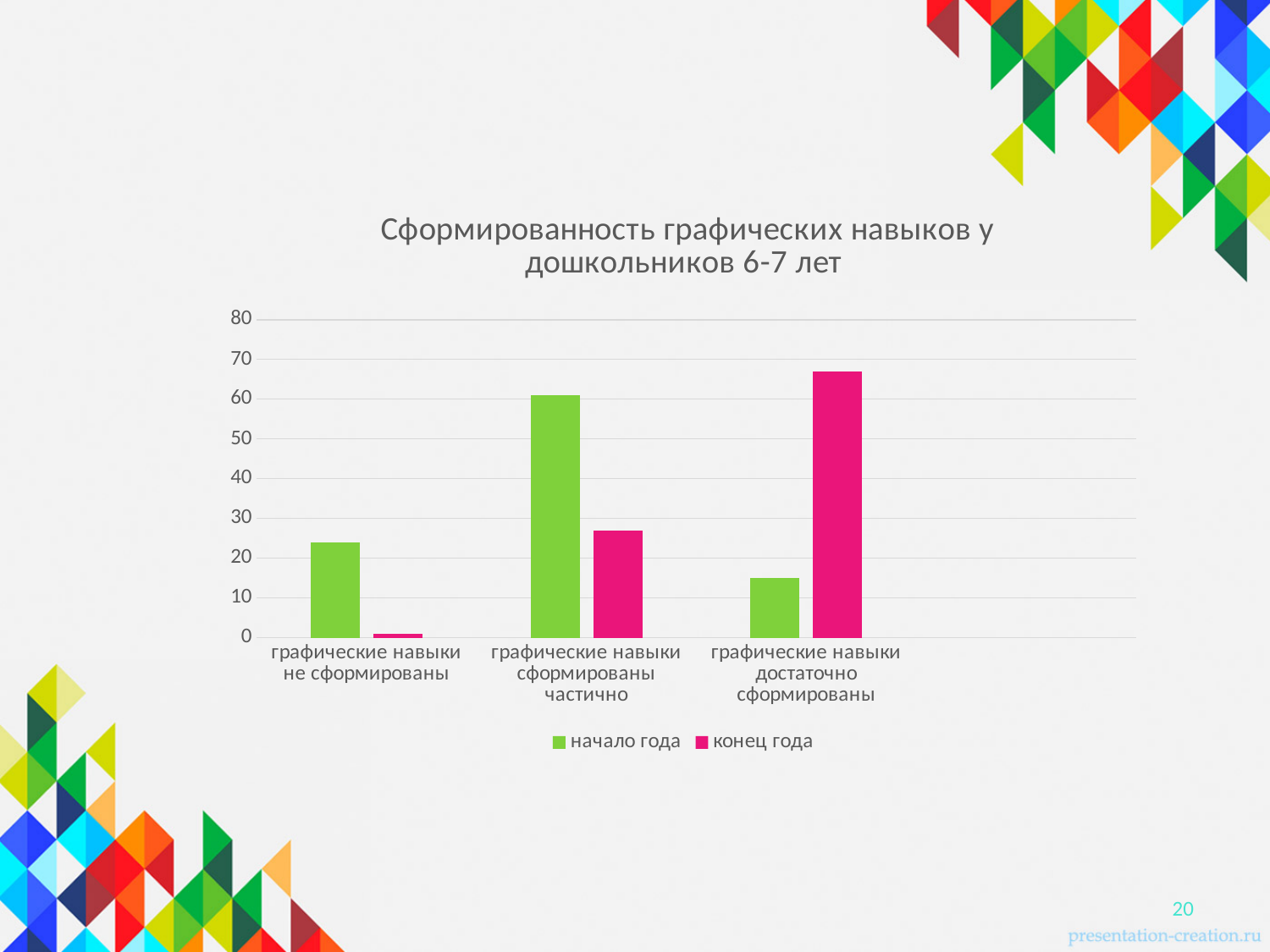
Which category has the highest value for the series 'конец года'? графические навыки достаточно сформированы Which category has the highest value for the series 'начало года'? графические навыки сформированы частично Is the value for 'начало года' in the category 'графические навыки не сформированы' greater or less than 30? less Which category has the lowest value for the series 'конец года'? графические навыки не сформированы Which category has the lowest value for the series 'начало года'? графические навыки достаточно сформированы How many series does the legend list? 2 What is the title of the chart? Сформированность графических навыков у дошкольников 6-7 лет Which colour represents the series 'конец года' in the legend? pink What kind of chart is shown on the slide? bar chart In the category 'графические навыки сформированы частично', which series has the larger value, 'начало года' or 'конец года'? начало года Is the value for 'конец года' in the category 'графические навыки достаточно сформированы' greater or less than 60? greater How many categories are shown on the x axis? 3